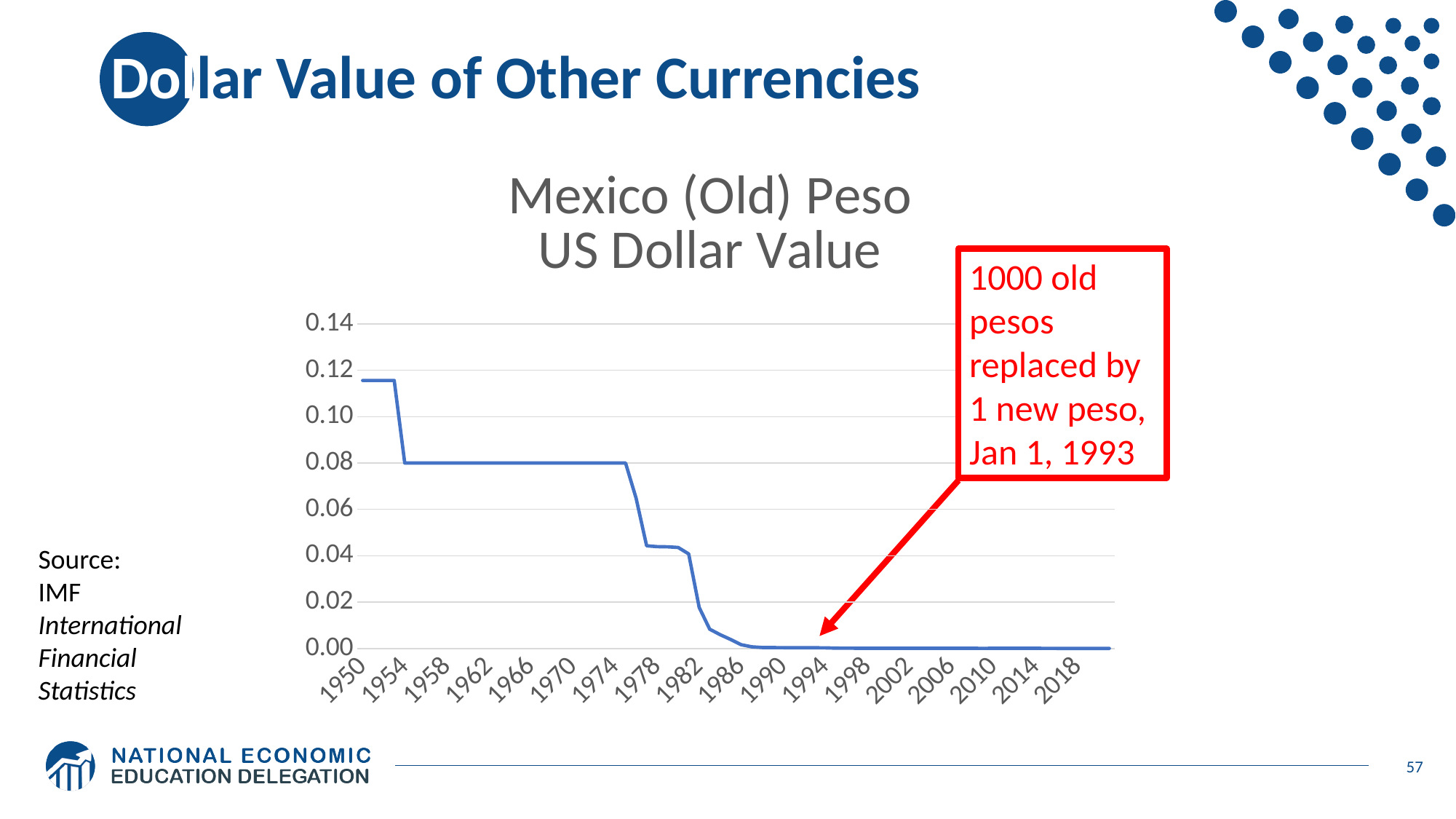
What is the title of the chart? Mexico (Old) Peso US Dollar Value Is the value for 1978 greater or less than 0.04? greater Which year shown on the x axis has the highest US dollar value of the old peso? 1950 Is the value in 1970 larger or smaller than the value in 1986? larger Is the value for 1950 greater or less than 0.10? greater What kind of chart is shown on the slide? line chart Is the value for 1990 greater or less than 0.02? less How many year labels are shown on the x axis? 18 What is the US dollar value of the old peso in 1966? 0.08 Do the values rise or fall from 1950 to 2018? fall